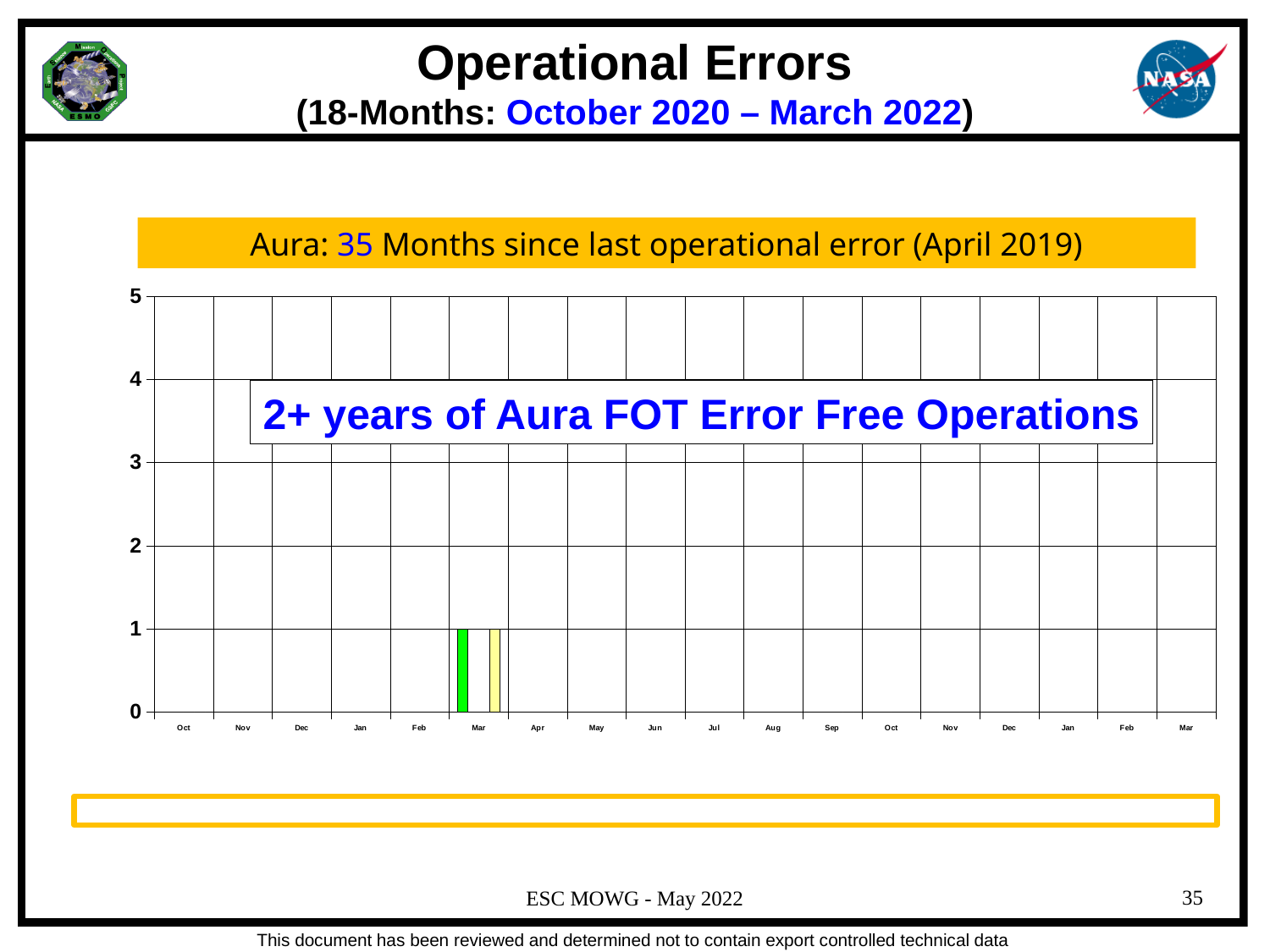
What is the total of the green and yellow bars at the first Mar on the x axis? 2 What value does the yellow bar at the first Mar on the x axis reach? 1 What text is written in the box overlaid on the chart? 2+ years of Aura FOT Error Free Operations What is the highest value shown on the y axis of the chart? 5 How many bars are plotted at the first Mar on the x axis? 2 What value does the green bar at the first Mar on the x axis reach? 1 Which month label appears first on the x axis of the chart? Oct How many month categories are shown along the x axis of the chart? 18 What kind of chart is shown on the slide? bar chart Which month on the x axis is the only one with bars plotted? Mar (the first Mar) Is the value of the green bar at the first Mar greater or less than 2? less